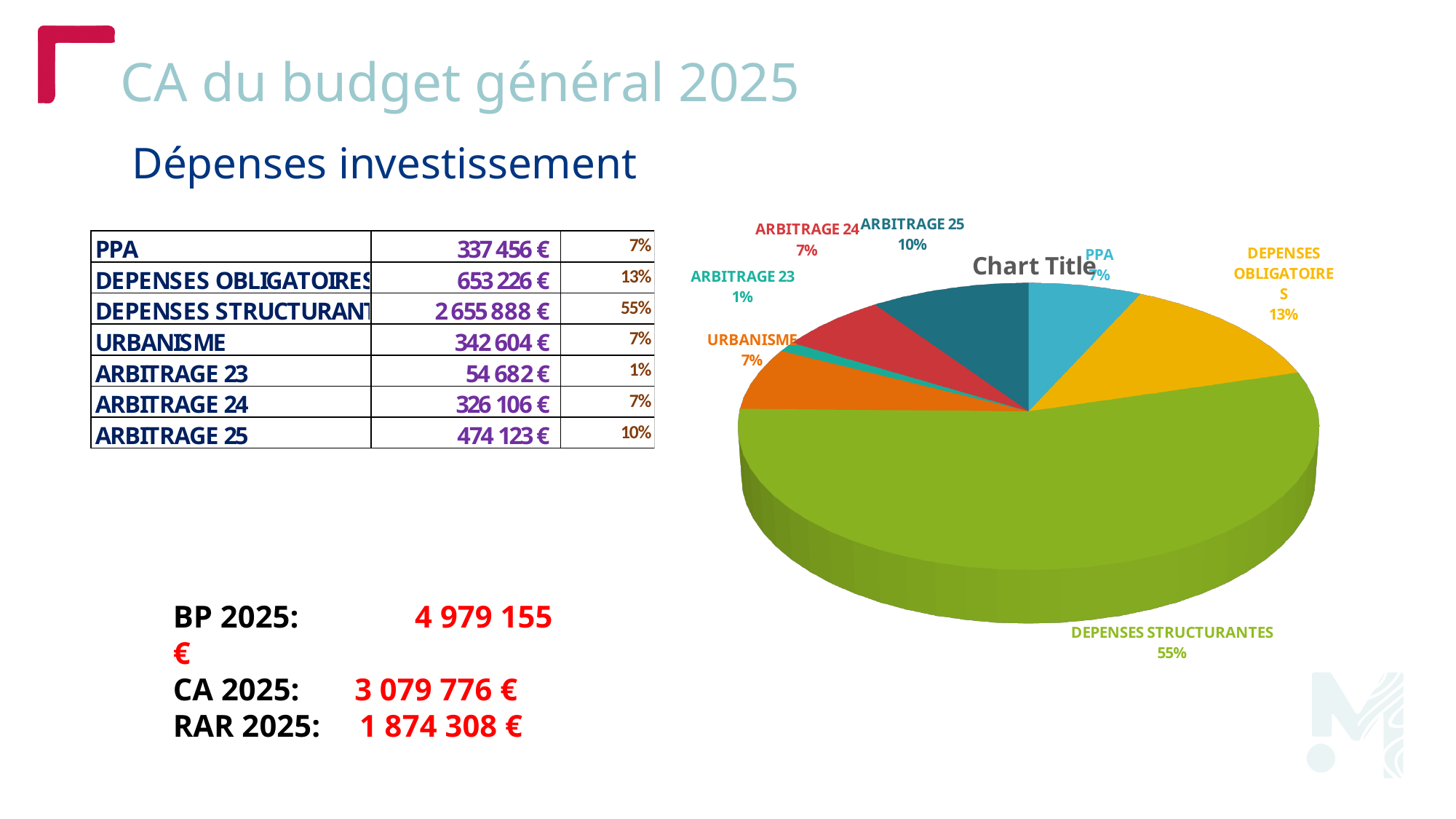
What colour is the DEPENSES STRUCTURANTES slice in the pie chart? green What is the title shown on the pie chart? Chart Title What kind of chart is shown on the slide? pie chart What share of the pie chart does DEPENSES OBLIGATOIRES represent? 13% What is the difference in percentage points between the DEPENSES STRUCTURANTES slice and the DEPENSES OBLIGATOIRES slice? 42 Which slice of the pie chart is the smallest? ARBITRAGE 23 What share of the pie chart does ARBITRAGE 23 represent? 1% In the pie chart, which is larger: DEPENSES OBLIGATOIRES or ARBITRAGE 25? DEPENSES OBLIGATOIRES What share of the pie chart does ARBITRAGE 25 represent? 10% Which slice of the pie chart is the largest? DEPENSES STRUCTURANTES How many slices does the pie chart have? 7